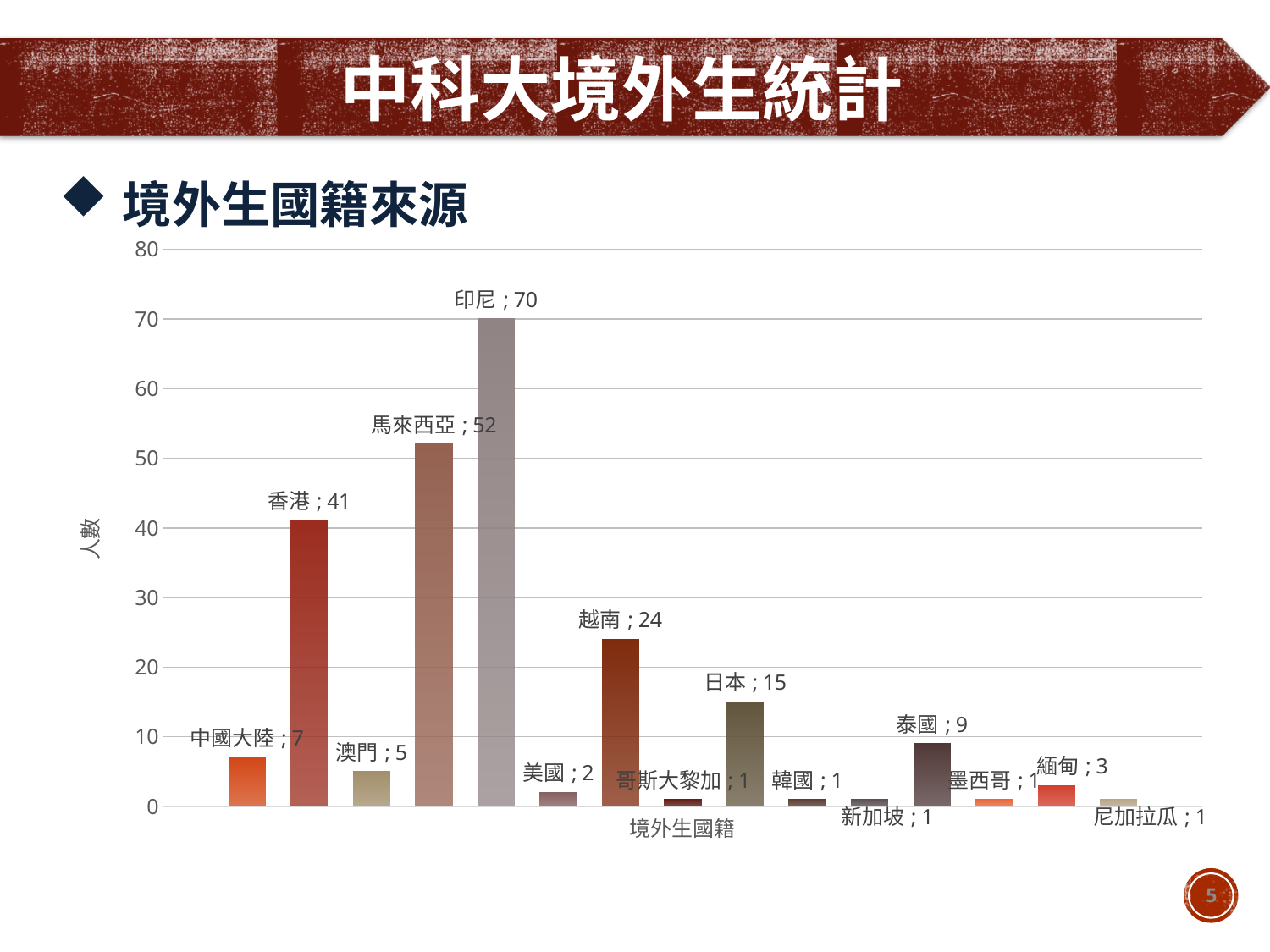
How many countries (categories) are shown on the x axis of the chart? 15 What is the value shown for 泰國? 9 What is the difference between the values for 印尼 and 馬來西亞? 18 What is the value shown for 馬來西亞? 52 Which is larger, the value for 香港 or the value for 越南? 香港 Which is larger, the value for 中國大陸 or the value for 澳門? 中國大陸 What is the difference between the values for 香港 and 日本? 26 How many students are from 印尼 according to the chart? 70 What is the label of the vertical axis of the chart? 人數 What is the value shown for 越南? 24 Which country has the highest number of students in the chart? 印尼 What kind of chart is shown on the slide? bar chart